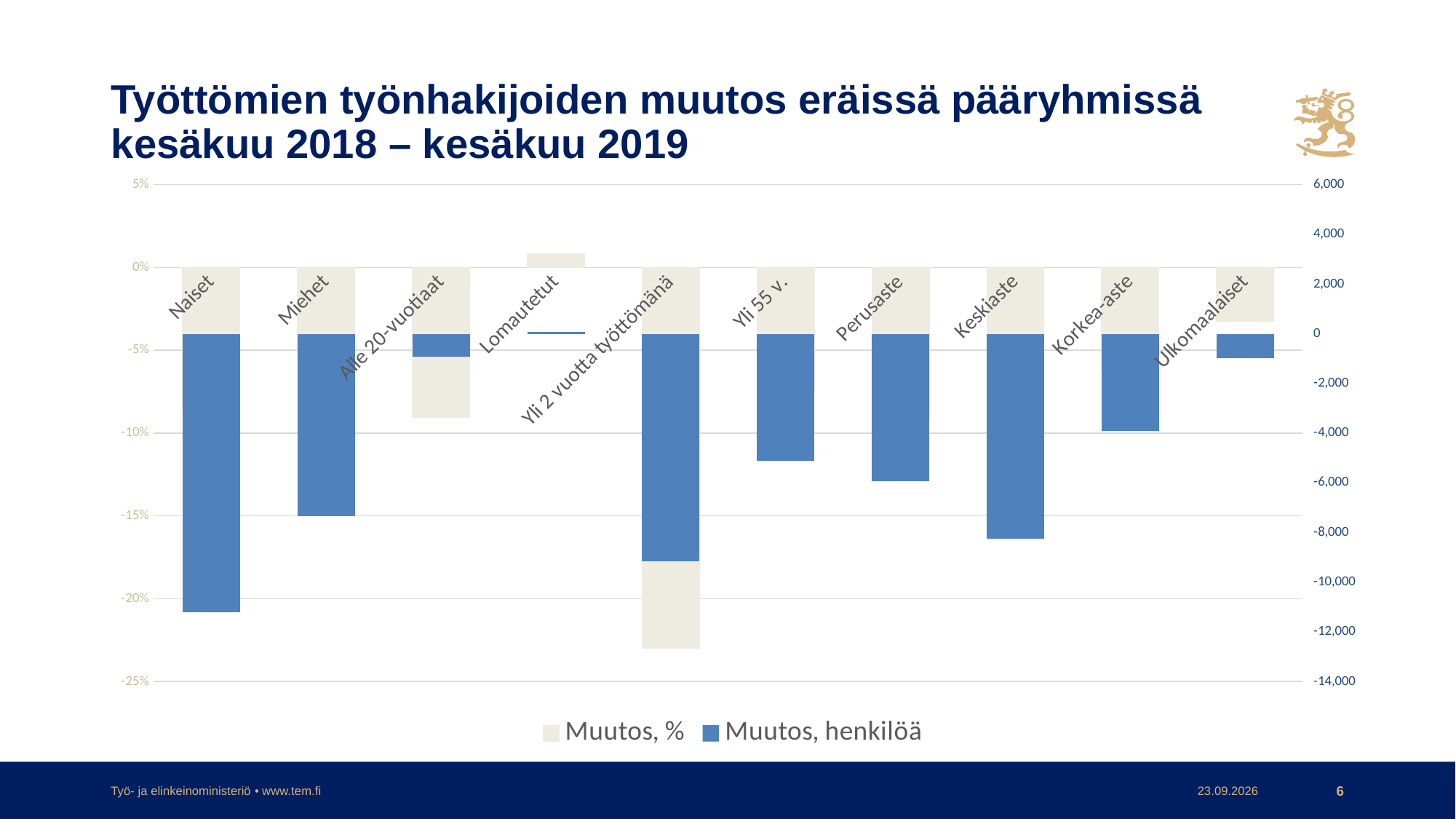
Which has the larger Muutos, henkilöä value, Naiset or Miehet? Miehet What kind of chart is shown on the slide? bar chart Is the Muutos, henkilöä value for Naiset greater or less than -10,000? less Which category has the lowest value for Muutos, henkilöä? Naiset How many categories are shown on the x axis? 10 How many series does the legend list? 2 Which has the larger Muutos, henkilöä value, Perusaste or Keskiaste? Perusaste What colour are the bars for the Muutos, henkilöä series? blue Is the Muutos, henkilöä value for Korkea-aste greater or less than -2,000? less Which category has the lowest value for Muutos, %? Yli 2 vuotta työttömänä Which category is the only one with a positive Muutos, % value? Lomautetut Is the Muutos, % value for Yli 2 vuotta työttömänä greater or less than -20%? less